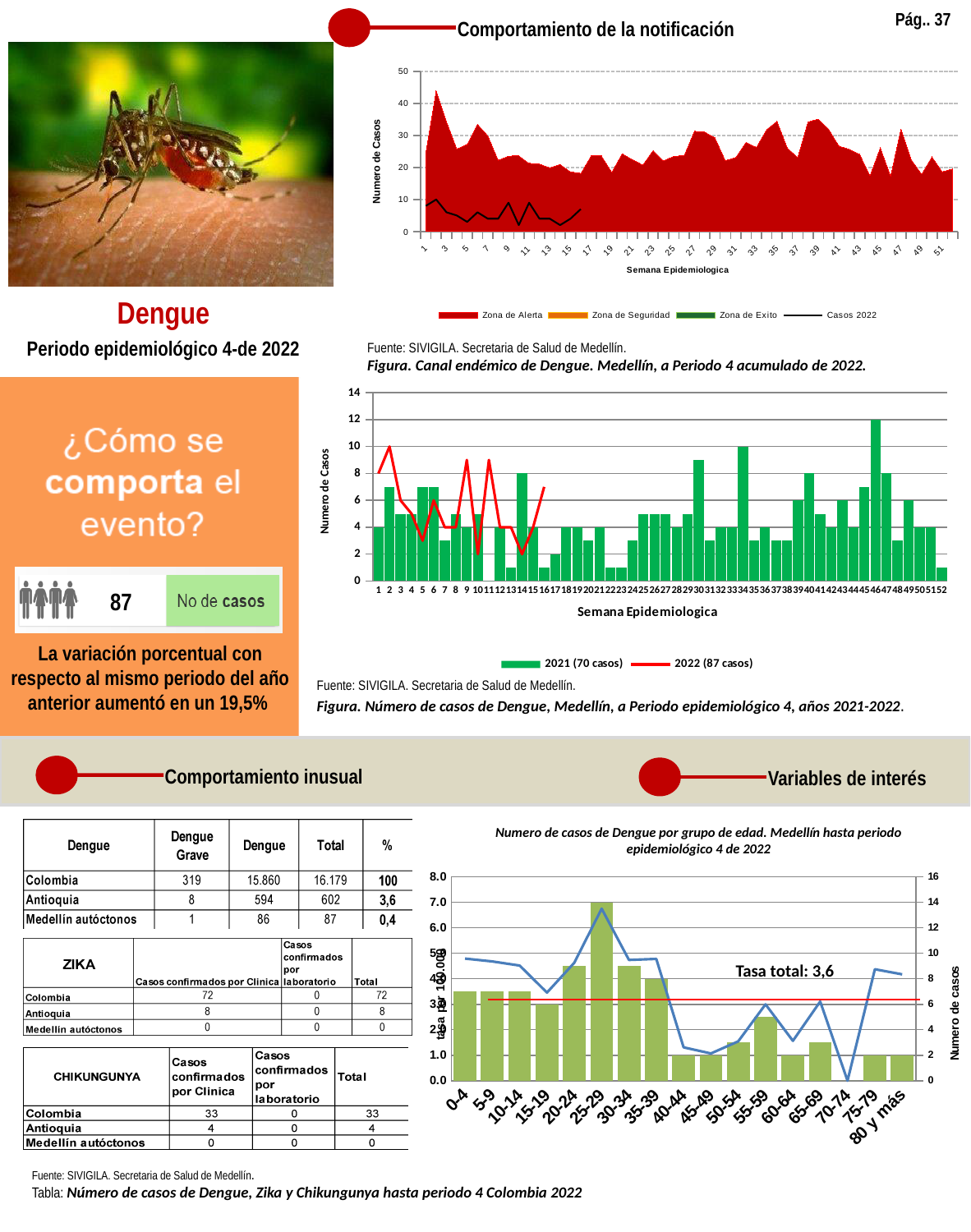
In the chart 'Canal endémico de Dengue' at the top right, how many entries does the legend list? 4 In the chart titled 'Numero de casos de Dengue por grupo de edad', which age group has the tallest bar? 25-29 In the chart titled 'Numero de casos de Dengue por grupo de edad', for which age group does the blue line reach its lowest point? 70-74 In the chart titled 'Numero de casos de Dengue por grupo de edad', what is the number of cases (right axis) for the 25-29 age group? 14 In the chart titled 'Numero de casos de Dengue por grupo de edad', is the blue line value for the 40-44 age group greater or less than 2.0? less In the chart 'Número de casos de Dengue, Medellín, a Periodo epidemiológico 4, años 2021-2022', how many series does the legend list? 2 In the chart 'Número de casos de Dengue, Medellín, a Periodo epidemiológico 4, años 2021-2022', what is the number of cases for week 46 in 2021? 12 In the chart 'Número de casos de Dengue, Medellín, a Periodo epidemiológico 4, años 2021-2022', what is the difference between the total cases for 2022 and 2021 shown in the legend? 17 In the chart titled 'Numero de casos de Dengue por grupo de edad', what total rate (Tasa total) is written on the chart? 3,6 In the chart 'Número de casos de Dengue, Medellín, a Periodo epidemiológico 4, años 2021-2022', which epidemiological week has the tallest green bar? 46 In the chart 'Número de casos de Dengue, Medellín, a Periodo epidemiológico 4, años 2021-2022', how many total cases does the legend give for 2022? 87 casos In the chart titled 'Numero de casos de Dengue por grupo de edad', how many age groups are shown on the x axis? 17